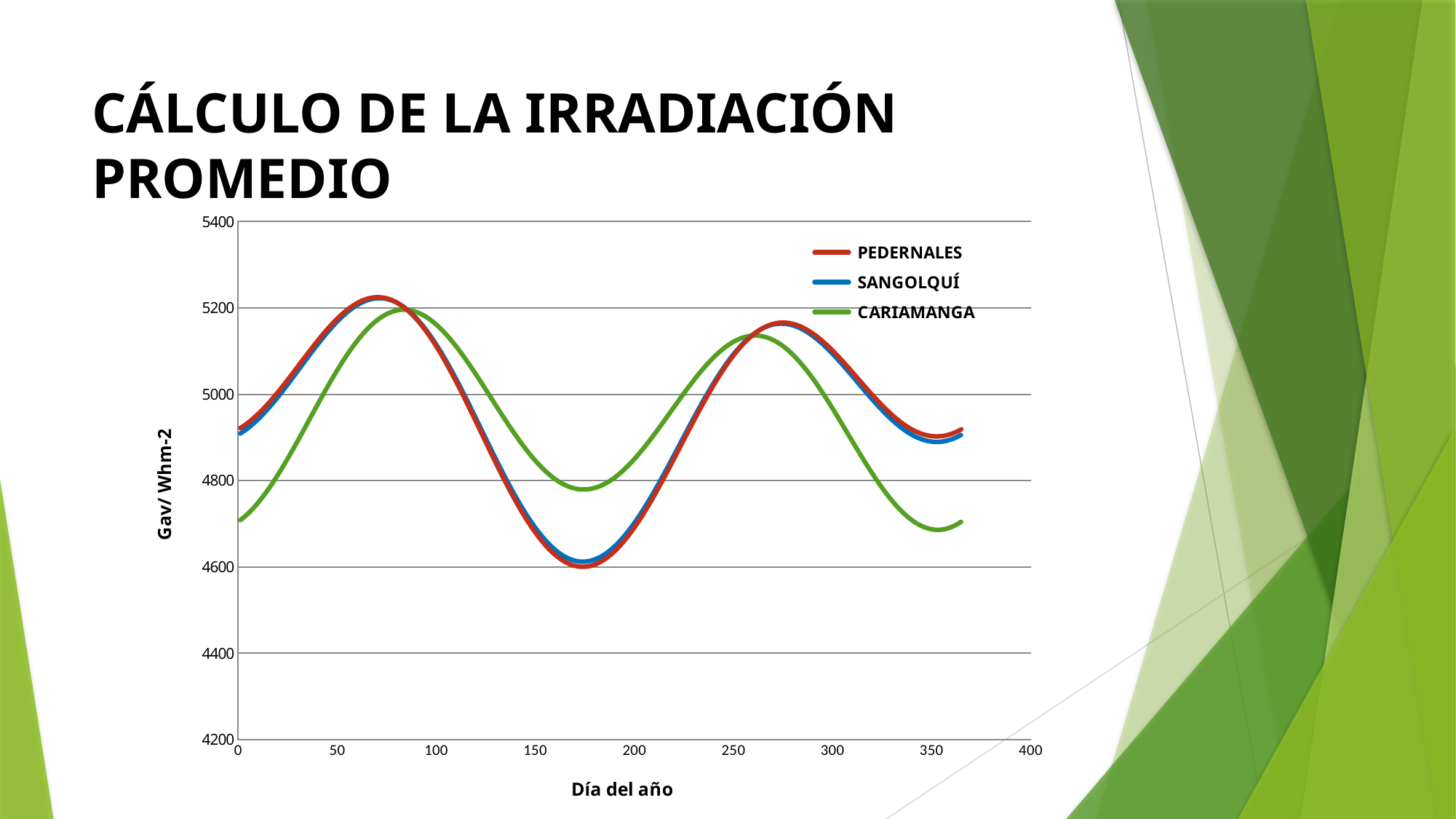
How many series does the legend list? 3 Which series are listed in the legend? PEDERNALES, SANGOLQUÍ, CARIAMANGA Is the lowest value of CARIAMANGA near day 355 greater or less than 4600? greater Is the lowest value of PEDERNALES near day 175 greater or less than 4800? less Is the value for CARIAMANGA at day 0 greater or less than 4800? less What is the label of the x axis? Día del año At day 0, which series has the higher value, PEDERNALES or CARIAMANGA? PEDERNALES At day 175, which series has the higher value, CARIAMANGA or SANGOLQUÍ? CARIAMANGA Does the PEDERNALES line rise or fall between day 100 and day 175? fall What kind of chart is shown on the slide? line chart